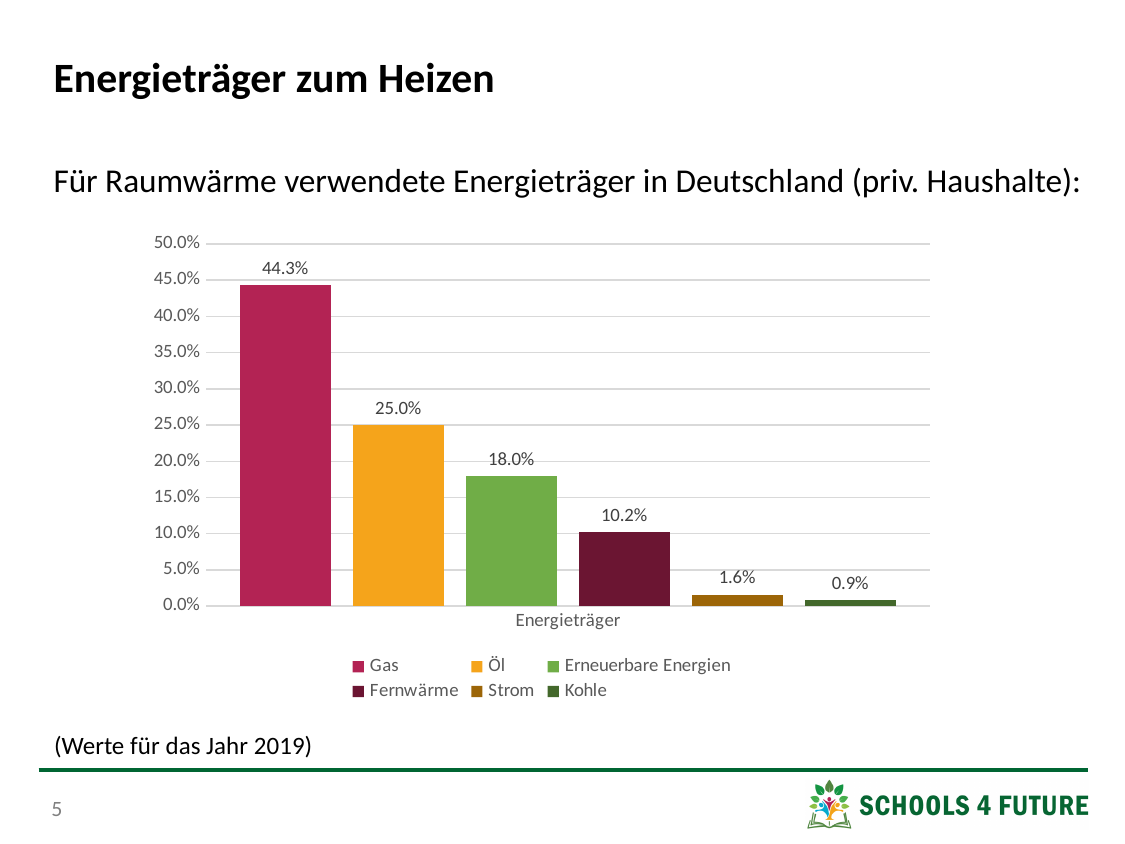
What is the value for Erneuerbare Energien? 18.0% What is the value for Gas? 44.3% What is the difference between the values for Gas and Öl? 19.3% Which energy source has the lowest share? Kohle Which energy source has the highest share? Gas What is the difference between the values for Fernwärme and Strom? 8.6% What is the value for Strom? 1.6% How many energy sources are shown in the chart? 6 What is the x-axis label of the chart? Energieträger What kind of chart is shown on the slide? bar chart Is the value for Fernwärme greater or less than 15.0%? less Which is larger, the value for Öl or the value for Erneuerbare Energien? Öl